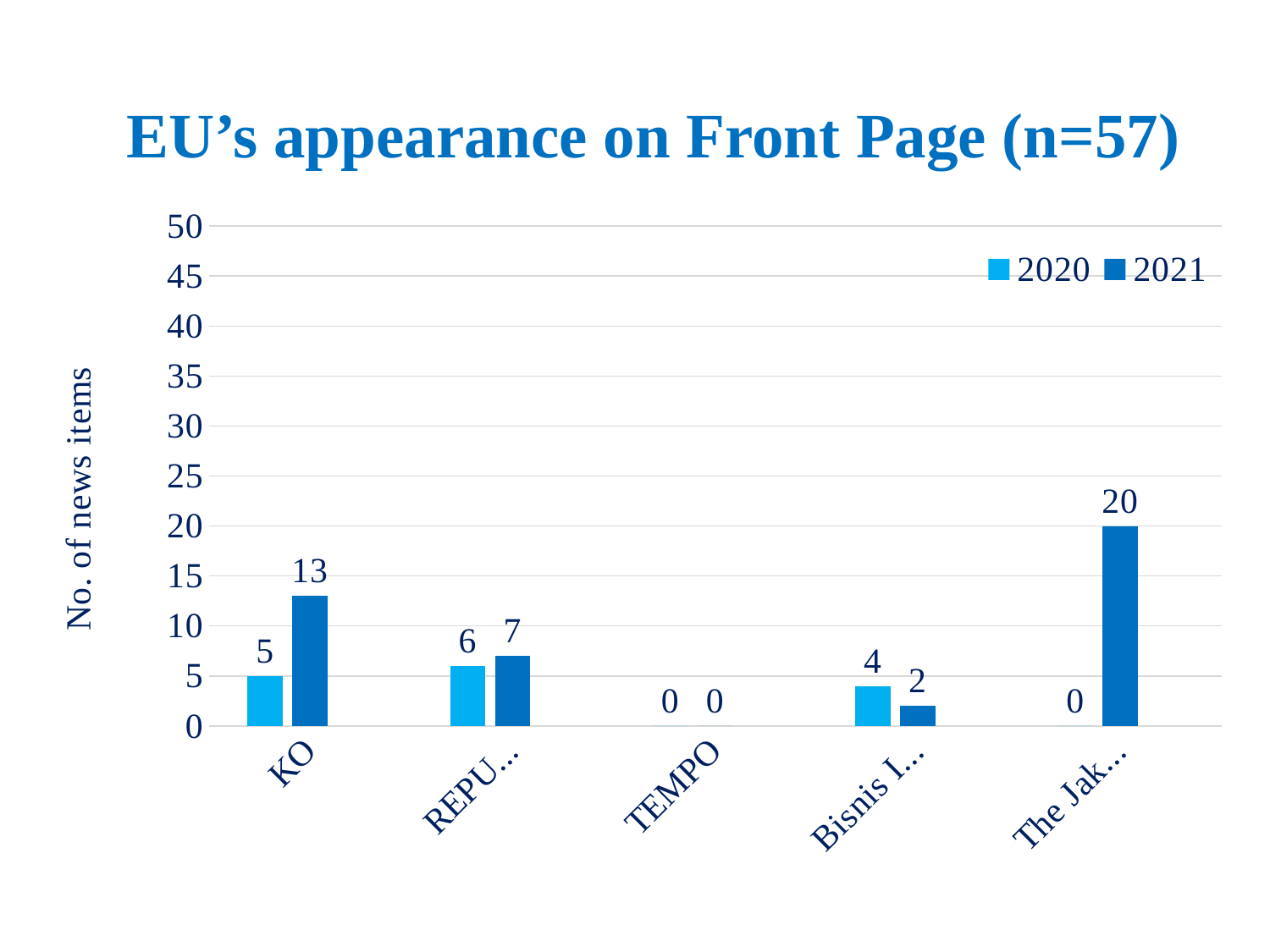
How many series does the legend list? 2 What is the 2020 value for KO? 5 What is the difference between the 2021 and 2020 values for KO? 8 What is the title of the chart? EU’s appearance on Front Page (n=57) How many categories are shown on the x axis? 5 What type of chart is shown on the slide? bar chart For KO, which series has the larger value, 2020 or 2021? 2021 What is the 2021 value for the rightmost category? 20 What is the label of the y axis? No. of news items What is the 2021 value for KO? 13 What is the 2020 value for TEMPO? 0 Which category has the highest 2021 value? The Jak... (rightmost category)